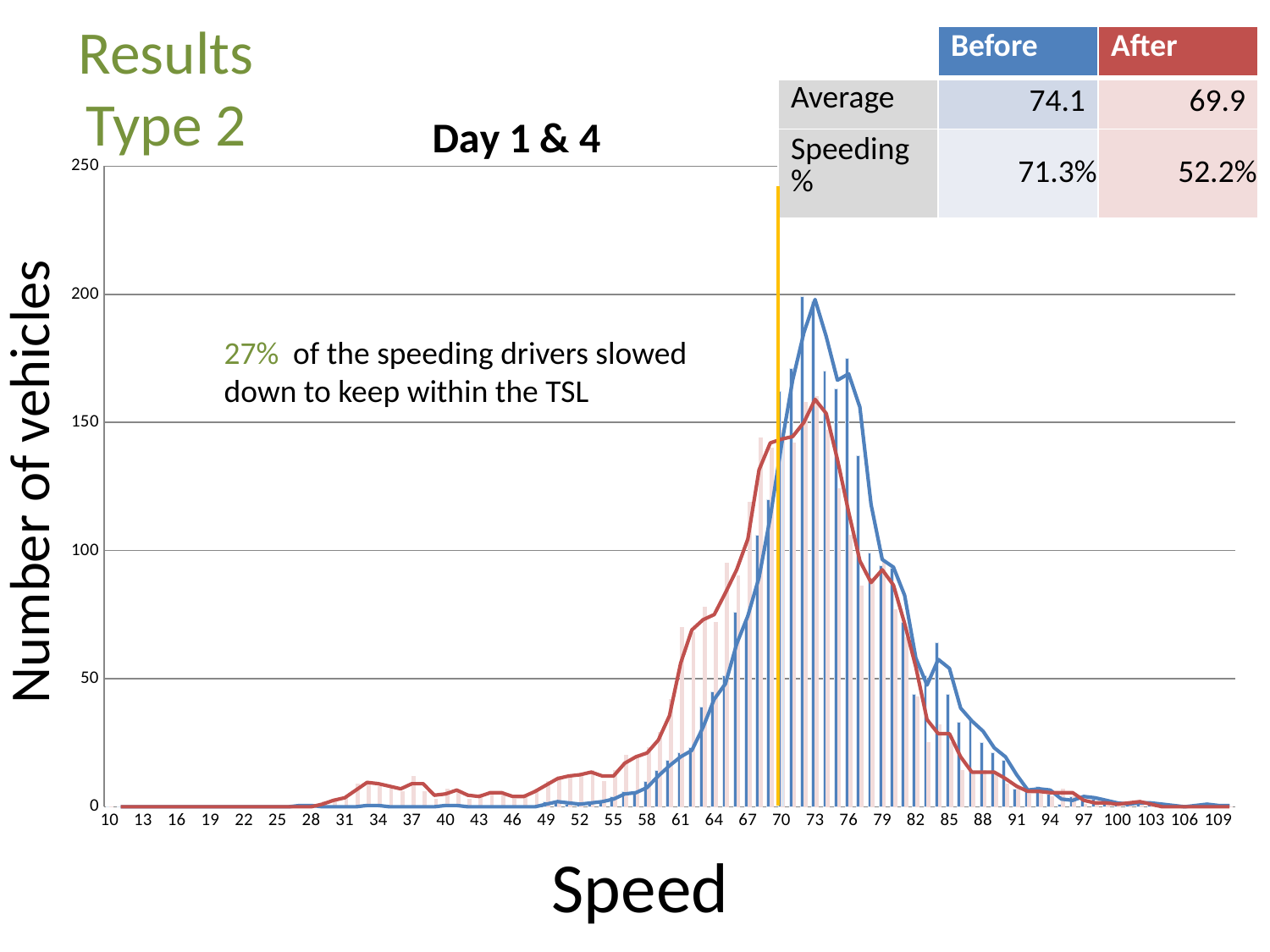
Is the red (After) value at speed 67 greater or less than 100? greater Is the red (After) value at speed 73 greater or less than 200? less At speed 73, which series is larger, the blue (Before) or the red (After)? Blue (Before) What is the label on the vertical axis of the chart? Number of vehicles At speed 61, which series is larger, the blue (Before) or the red (After)? Red (After) What is the title of the chart? Day 1 & 4 What kind of chart is shown on the slide? A bar chart with line overlays What is the first speed value shown on the horizontal axis? 10 Is the blue (Before) value at speed 61 greater or less than 50? less What is the last speed value shown on the horizontal axis? 109 What is the highest value shown on the vertical axis of the chart? 250